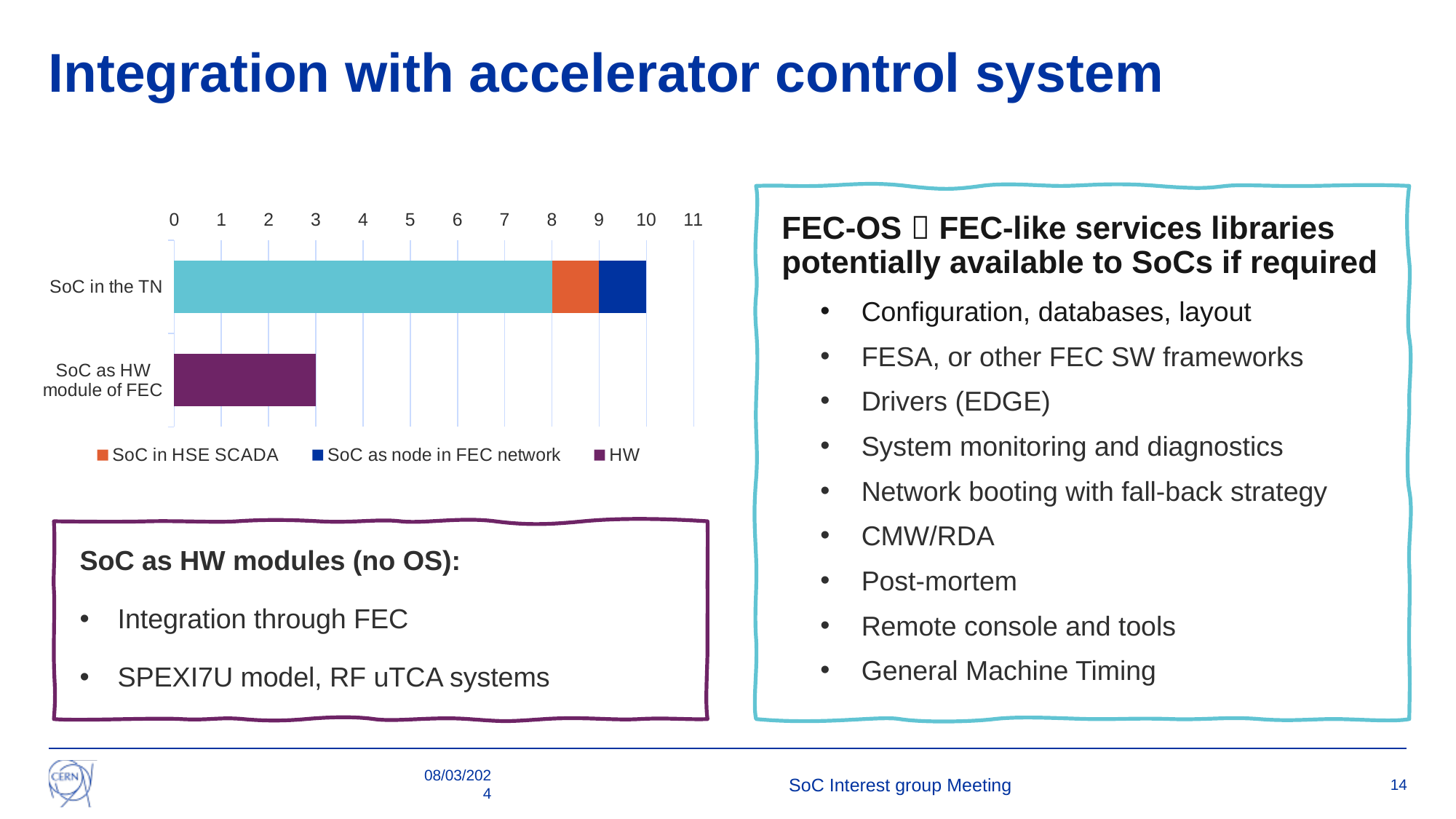
What kind of chart is shown on the slide? bar chart Which category has the longest total bar in the chart? SoC in the TN How many series does the chart legend list? 3 Which category has the longer bar, SoC in the TN or SoC as HW module of FEC? SoC in the TN At what axis value does the stacked bar for SoC in the TN end? 10 At what axis value does the bar for SoC as HW module of FEC end? 3 What colour represents the HW series in the chart legend? purple Which category has the shortest total bar in the chart? SoC as HW module of FEC Is the bar for SoC as HW module of FEC greater or less than 5? less Is the total bar for SoC in the TN greater or less than 5? greater What is the highest tick value shown on the chart's horizontal axis? 11 How many categories are shown on the vertical axis of the chart? 2